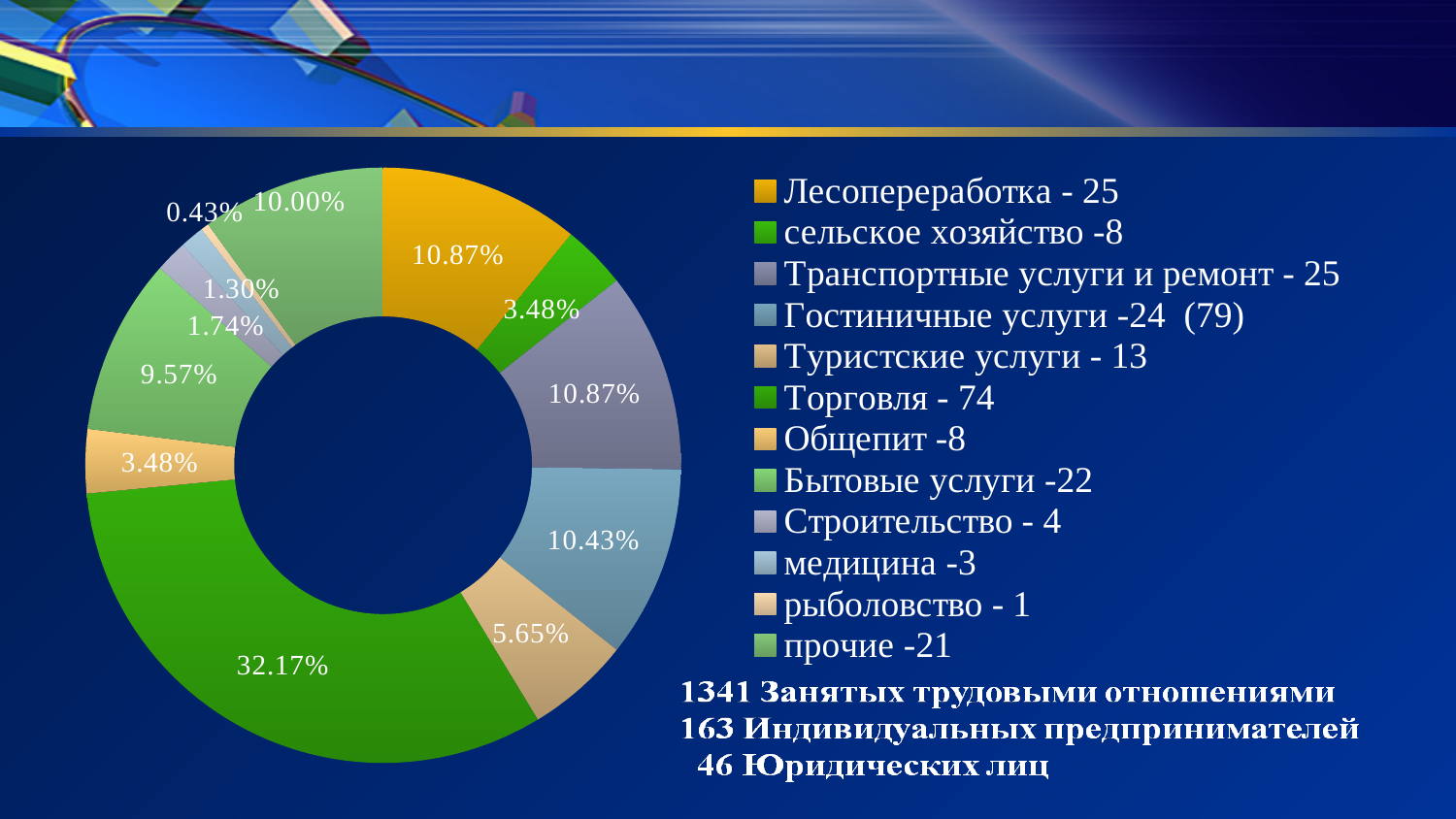
What is the difference in percentage points between the Торговля slice and the Лесопереработка slice? 21.30% What percentage share does the Гостиничные услуги slice have? 10.43% What kind of chart is shown on the slide? doughnut chart How many categories does the legend of the pie chart list? 12 Which category has the largest slice of the pie? Торговля What number is shown next to Строительство in the legend? 4 What percentage share does the Торговля slice have? 32.17% What number is shown next to Торговля in the legend? 74 What percentage share does the Лесопереработка slice have? 10.87% Which category has the smallest slice of the pie? рыболовство What percentage share does the Туристские услуги slice have? 5.65% Which slice is larger: Бытовые услуги or Туристские услуги? Бытовые услуги